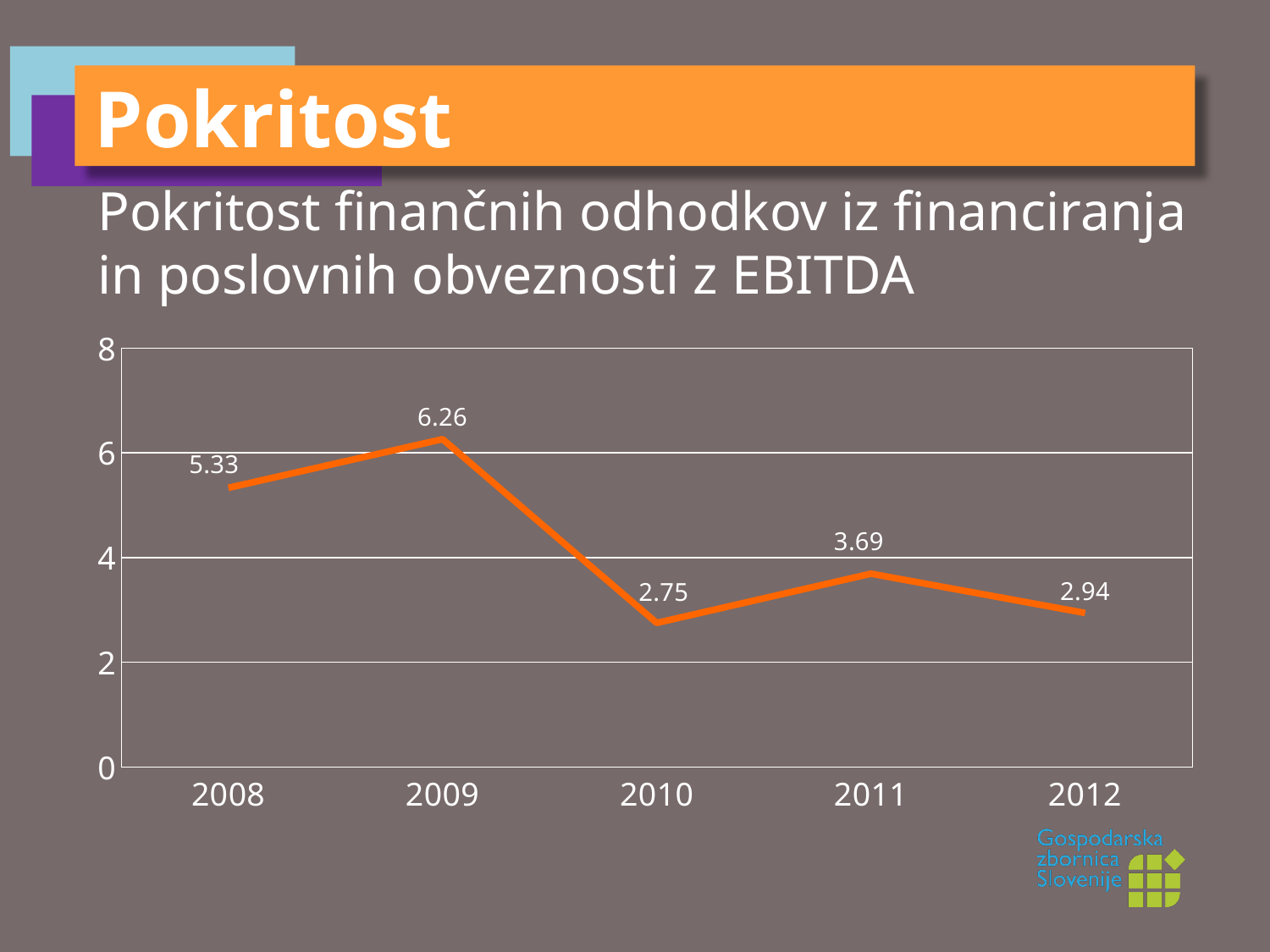
Is the value for 2008 greater or less than 4? greater Does the value rise or fall from 2009 to 2010? fall What is the value for 2008? 5.33 What is the value for 2009? 6.26 What is the value for 2012? 2.94 Which is larger, the value for 2011 or the value for 2012? 2011 What kind of chart is shown on the slide? line chart Which year has the lowest value? 2010 What is the title shown in the orange banner at the top of the slide? Pokritost How many years are plotted on the chart? 5 What is the difference between the values for 2009 and 2010? 3.51 Which year has the highest value? 2009